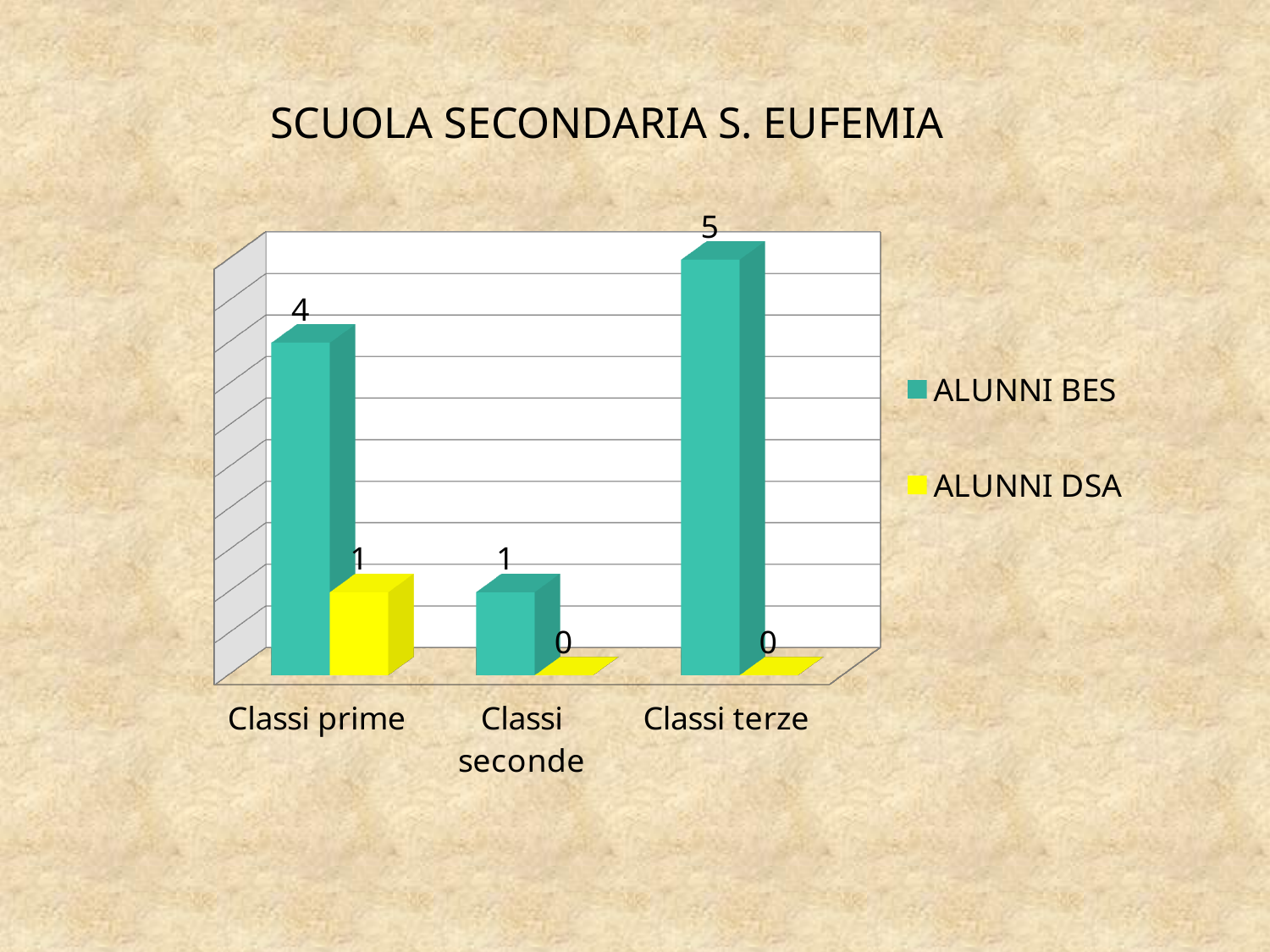
What is the value for ALUNNI DSA in Classi prime? 1 Which category has the highest value for ALUNNI BES? Classi terze What is the value for ALUNNI DSA in Classi terze? 0 What is the value for ALUNNI BES in Classi prime? 4 What is the value for ALUNNI BES in Classi terze? 5 What kind of chart is shown on the slide? Bar chart What is the value for ALUNNI BES in Classi seconde? 1 Which is larger: ALUNNI BES in Classi prime or ALUNNI BES in Classi seconde? Classi prime How many categories are shown on the x axis? 3 How many series does the legend list? 2 Which category has the lowest value for ALUNNI BES? Classi seconde What is the difference between ALUNNI BES in Classi terze and Classi prime? 1